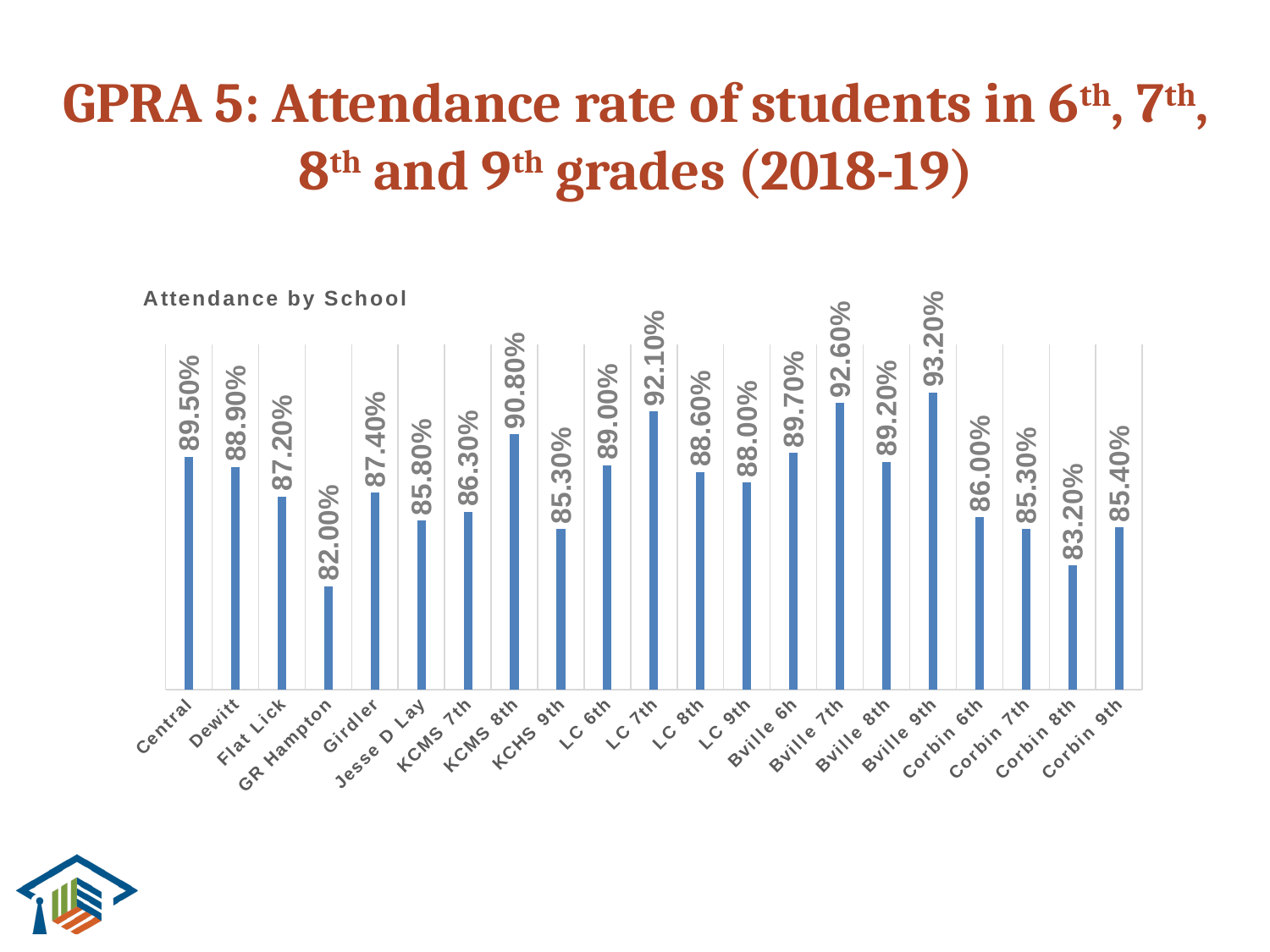
What is the attendance rate for Central? 89.50% What is the title of the chart? Attendance by School What is the difference in attendance rate between Bville 9th and GR Hampton? 11.20% What type of chart is shown on the slide? Bar chart What is the attendance rate for KCMS 8th? 90.80% What is the difference in attendance rate between LC 7th and LC 8th? 3.50% Which school has the highest attendance rate? Bville 9th What is the attendance rate for Corbin 8th? 83.20% How many schools or grade groups are shown in the chart? 21 Which school has the lowest attendance rate? GR Hampton Which has a higher attendance rate, Dewitt or Flat Lick? Dewitt What is the attendance rate for LC 7th? 92.10%